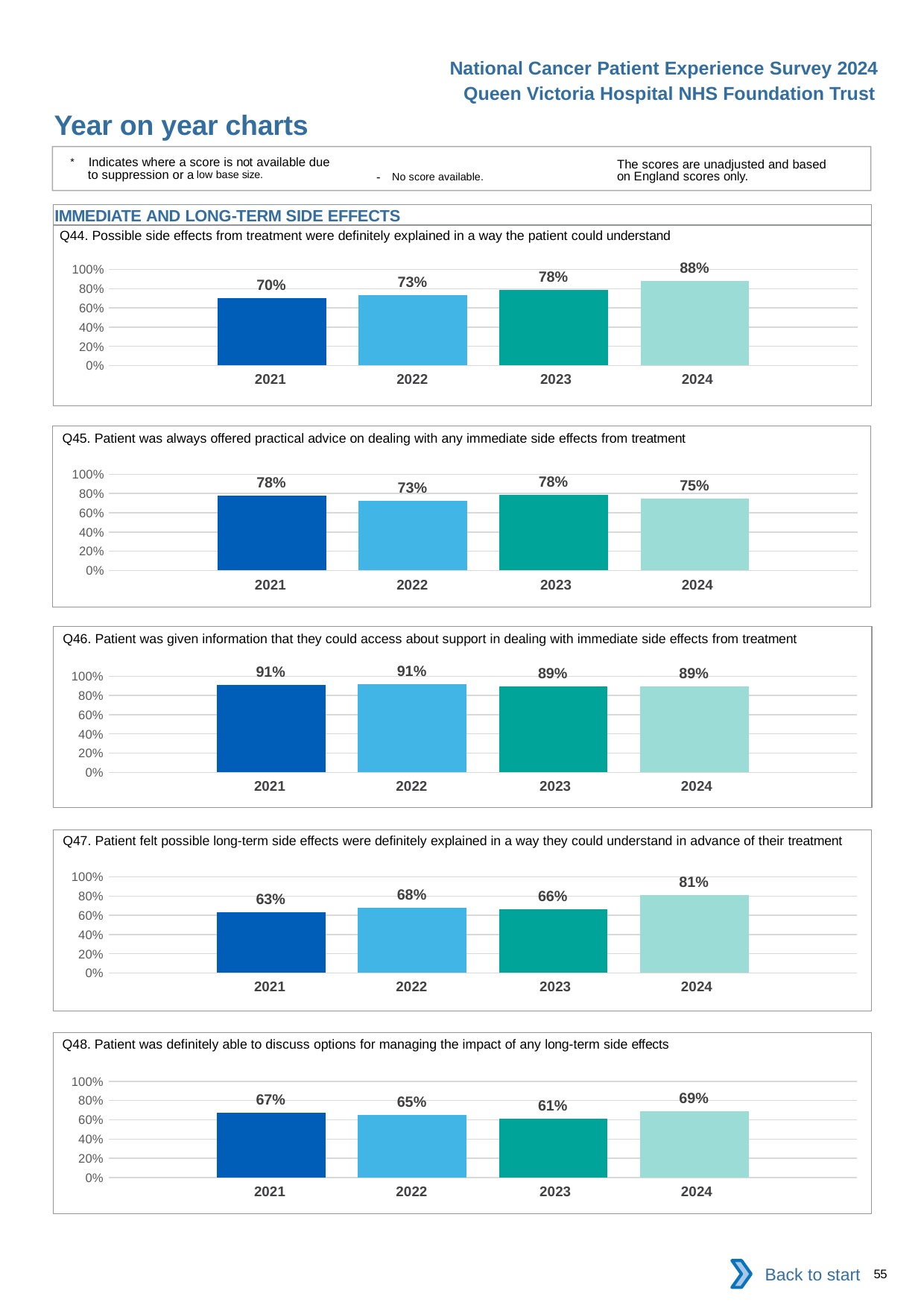
In the Q46 chart, what is the value for 2021? 91% In the Q44 chart, what is the difference between the 2024 and 2021 values? 18 percentage points What kind of chart is the Q44 chart? Bar chart In the Q44 chart, which year has the lowest value? 2021 In the Q47 chart, what is the difference between the 2022 and 2021 values? 5 percentage points In the Q45 chart, which is larger, the value for 2023 or the value for 2024? 2023 In the Q48 chart, what is the value for 2024? 69% In the Q46 chart, how many years are shown on the x axis? 4 In the Q45 chart, what is the value for 2022? 73% In the Q44 chart, what is the value for 2024? 88% In the Q47 chart, which year has the highest value? 2024 In the Q48 chart, which year has the lowest value? 2023